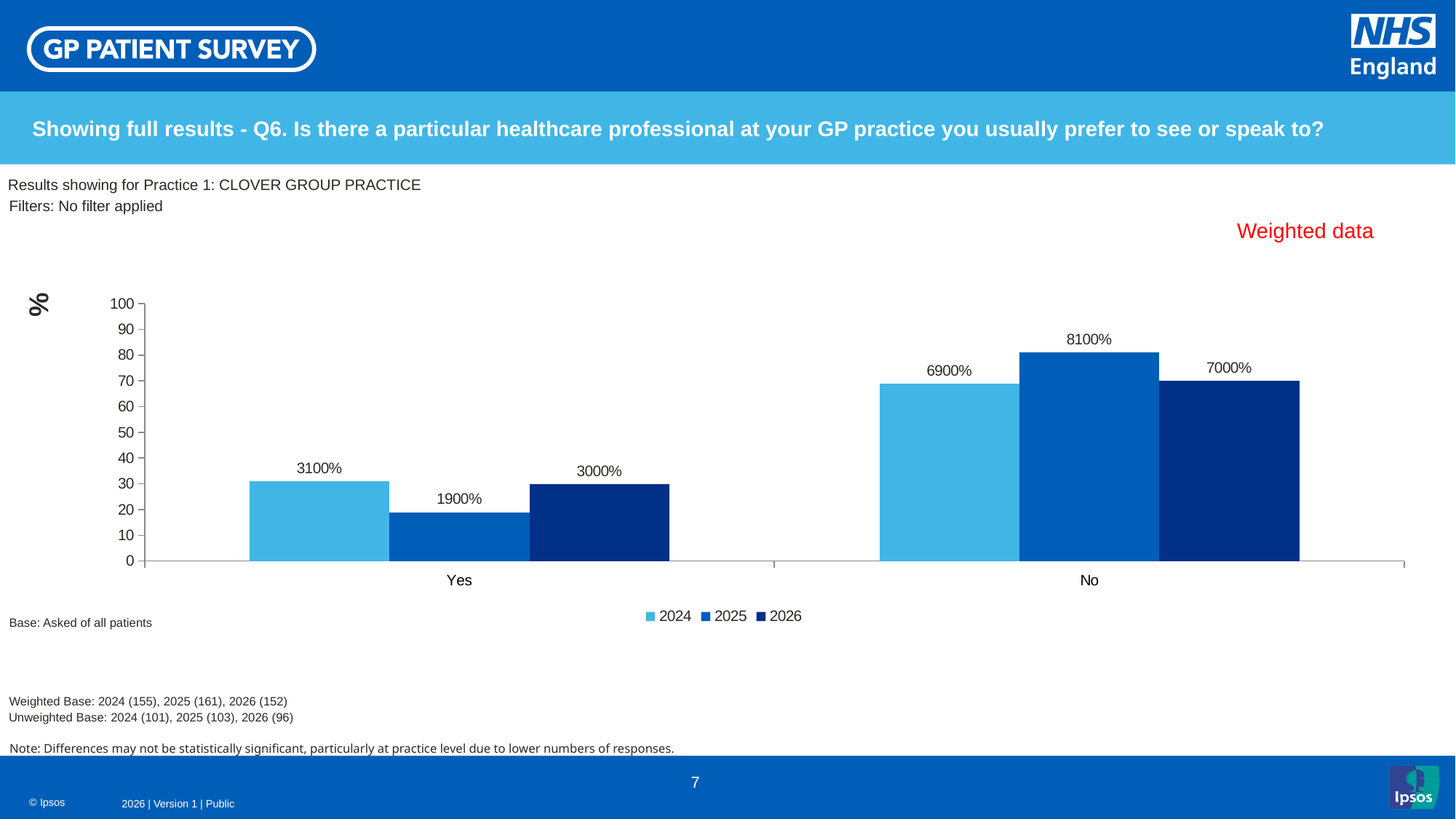
How many series does the legend list? 3 What is the data label for 2025 in the No category? 8100% What kind of chart is shown on the slide? bar chart How many categories are shown on the x axis? 2 What is the data label for 2026 in the Yes category? 3000% What is the data label for 2024 in the Yes category? 3100% Which is larger in the No category, the 2024 bar or the 2026 bar? 2026 Is the 2025 bar in the Yes category greater or less than 20 on the axis? less Which year has the highest bar in the No category? 2025 What is the data label for 2024 in the No category? 6900% Which practice are the results shown for? CLOVER GROUP PRACTICE Which year has the lowest bar in the Yes category? 2025